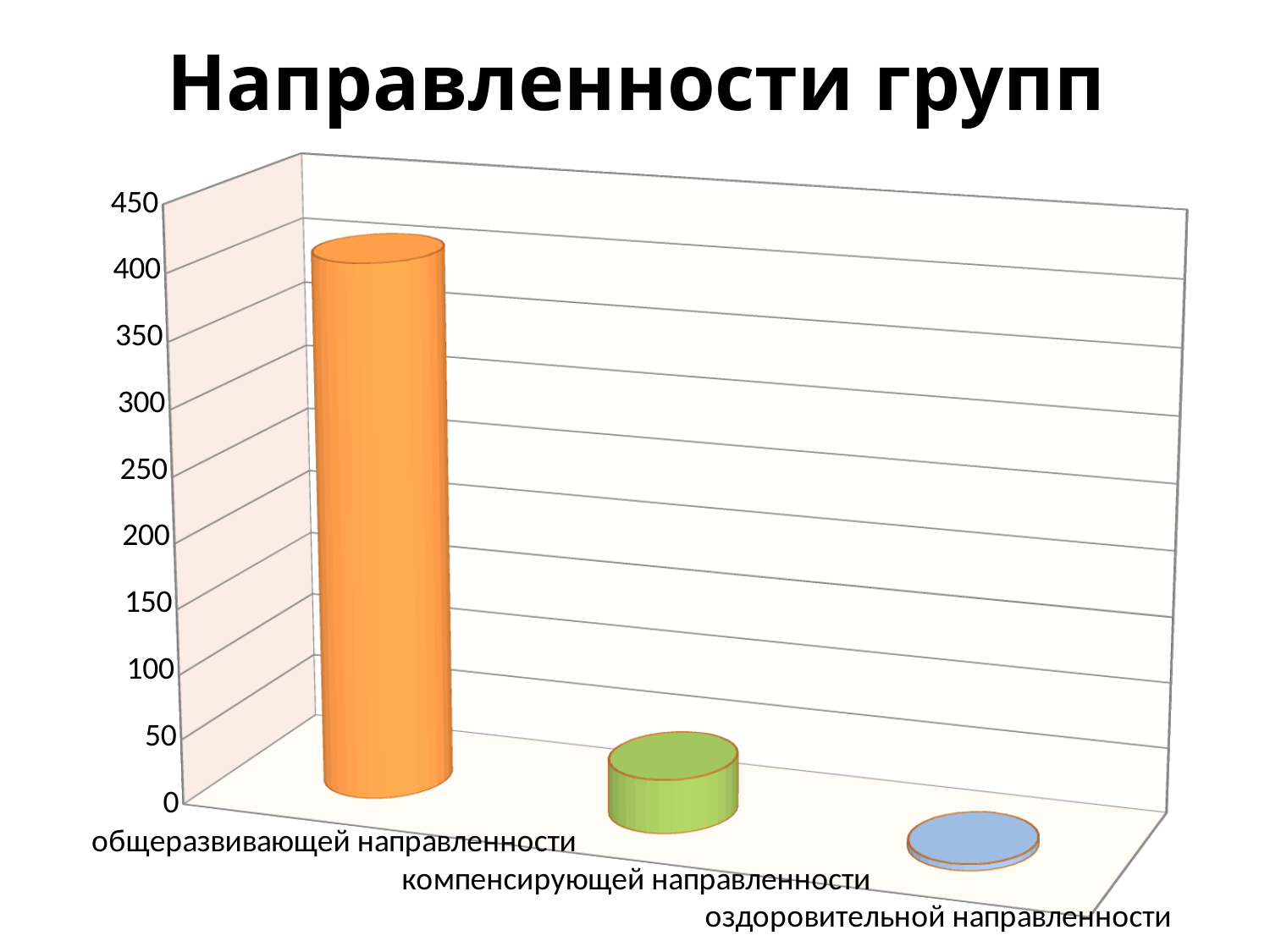
What colour is the bar for общеразвивающей направленности? orange Which is larger: the value for общеразвивающей направленности or the value for компенсирующей направленности? общеразвивающей направленности How many categories are plotted in the chart? 3 What is the title of the chart? Направленности групп Do the values rise or fall from left to right along the x axis? fall Which category has the highest value? общеразвивающей направленности What kind of chart is shown on the slide? bar chart Which is larger: the value for компенсирующей направленности or the value for оздоровительной направленности? компенсирующей направленности Which category has the lowest value? оздоровительной направленности Is the value for оздоровительной направленности greater or less than 50? less Is the value for общеразвивающей направленности greater or less than 350? greater Is the value for компенсирующей направленности greater or less than 100? less